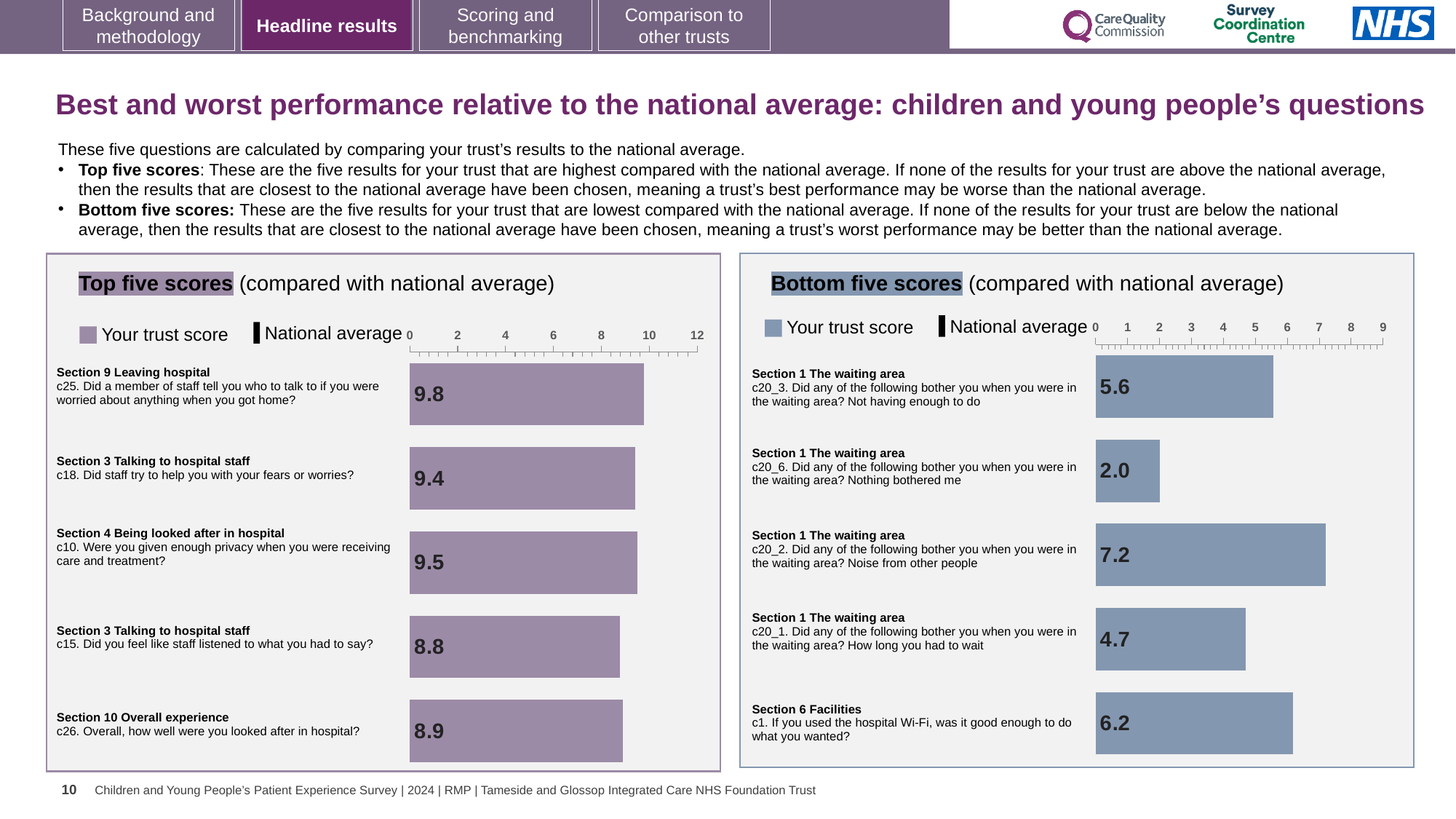
In the Top five scores chart, what is the trust score for c25 (Did a member of staff tell you who to talk to if you were worried about anything when you got home)? 9.8 In the Bottom five scores chart, what is the difference between the trust scores for c20_2 and c20_6? 5.2 In the Bottom five scores chart, what is the trust score for c1 (If you used the hospital Wi-Fi, was it good enough to do what you wanted)? 6.2 In the Bottom five scores chart, what is the trust score for c20_6 (Nothing bothered me)? 2.0 In the Bottom five scores chart, which has the larger trust score: c20_3 (Not having enough to do) or c20_1 (How long you had to wait)? c20_3 (Not having enough to do) In the Bottom five scores chart, which question has the highest trust score? c20_2. Did any of the following bother you when you were in the waiting area? Noise from other people In the Top five scores chart, which question has the highest trust score? c25. Did a member of staff tell you who to talk to if you were worried about anything when you got home? In the Top five scores chart, what is the trust score for c15 (Did you feel like staff listened to what you had to say)? 8.8 How many questions are shown in the Top five scores chart? 5 What type of chart is the Bottom five scores chart? Bar chart In the Bottom five scores chart, which question has the lowest trust score? c20_6. Did any of the following bother you when you were in the waiting area? Nothing bothered me In the Top five scores chart, what is the difference between the trust scores for c25 and c15? 1.0